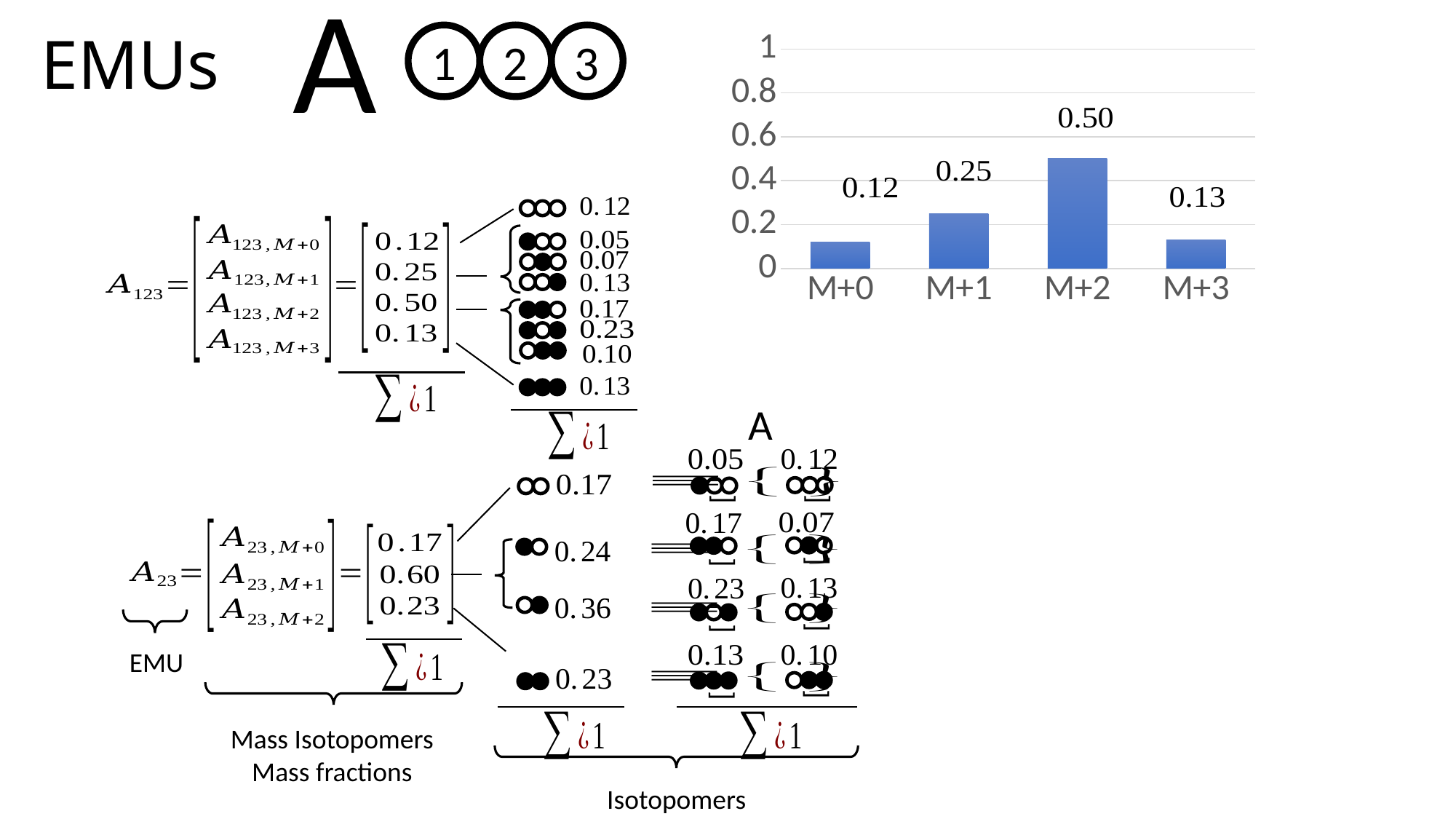
Which category has the highest value in the bar chart? M+2 What kind of chart is shown on the slide? bar chart Is the value for M+2 in the bar chart greater or less than 0.4? greater What is the value for M+2 in the bar chart? 0.50 Which category has the lowest value in the bar chart? M+0 Which is larger in the bar chart, the value for M+1 or the value for M+3? M+1 What is the total of the four values shown in the bar chart? 1.00 What is the highest tick value shown on the y axis of the bar chart? 1 What is the value for M+3 in the bar chart? 0.13 What is the value for M+0 in the bar chart? 0.12 What is the difference between the values for M+2 and M+1 in the bar chart? 0.25 How many categories are shown on the x axis of the bar chart? 4